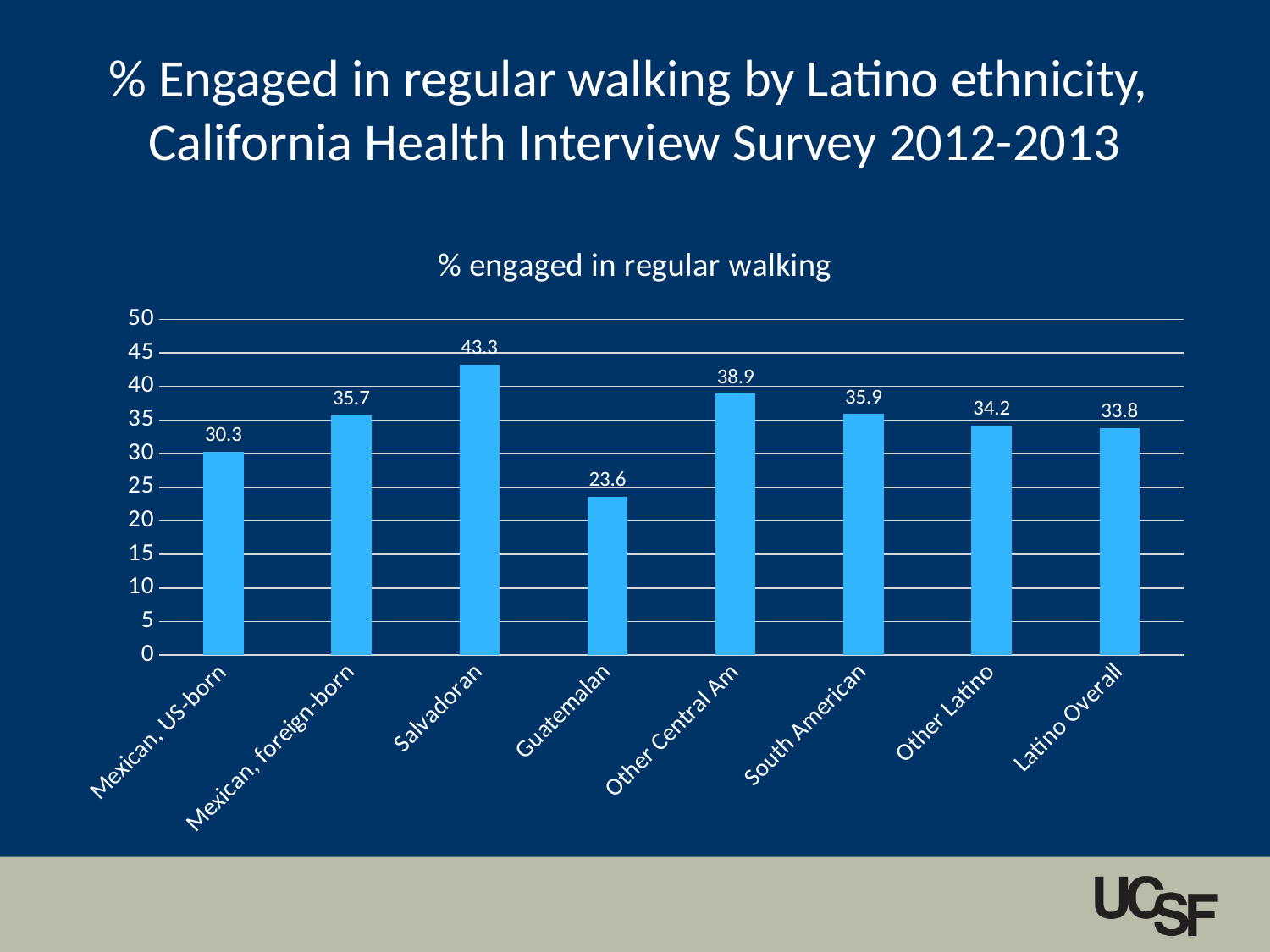
What is the value for Mexican, foreign-born? 35.7 What kind of chart is this? bar chart What is the value for Guatemalan? 23.6 What is the value for Salvadoran? 43.3 Is the value for Mexican, US-born greater or less than 35? less Which is larger, the value for Other Central Am or the value for South American? Other Central Am Which category has the lowest value? Guatemalan Which category has the highest value? Salvadoran How many categories are shown on the x axis? 8 What is the difference between the values for Salvadoran and Guatemalan? 19.7 What is the title of the chart? % engaged in regular walking What is the value for Latino Overall? 33.8